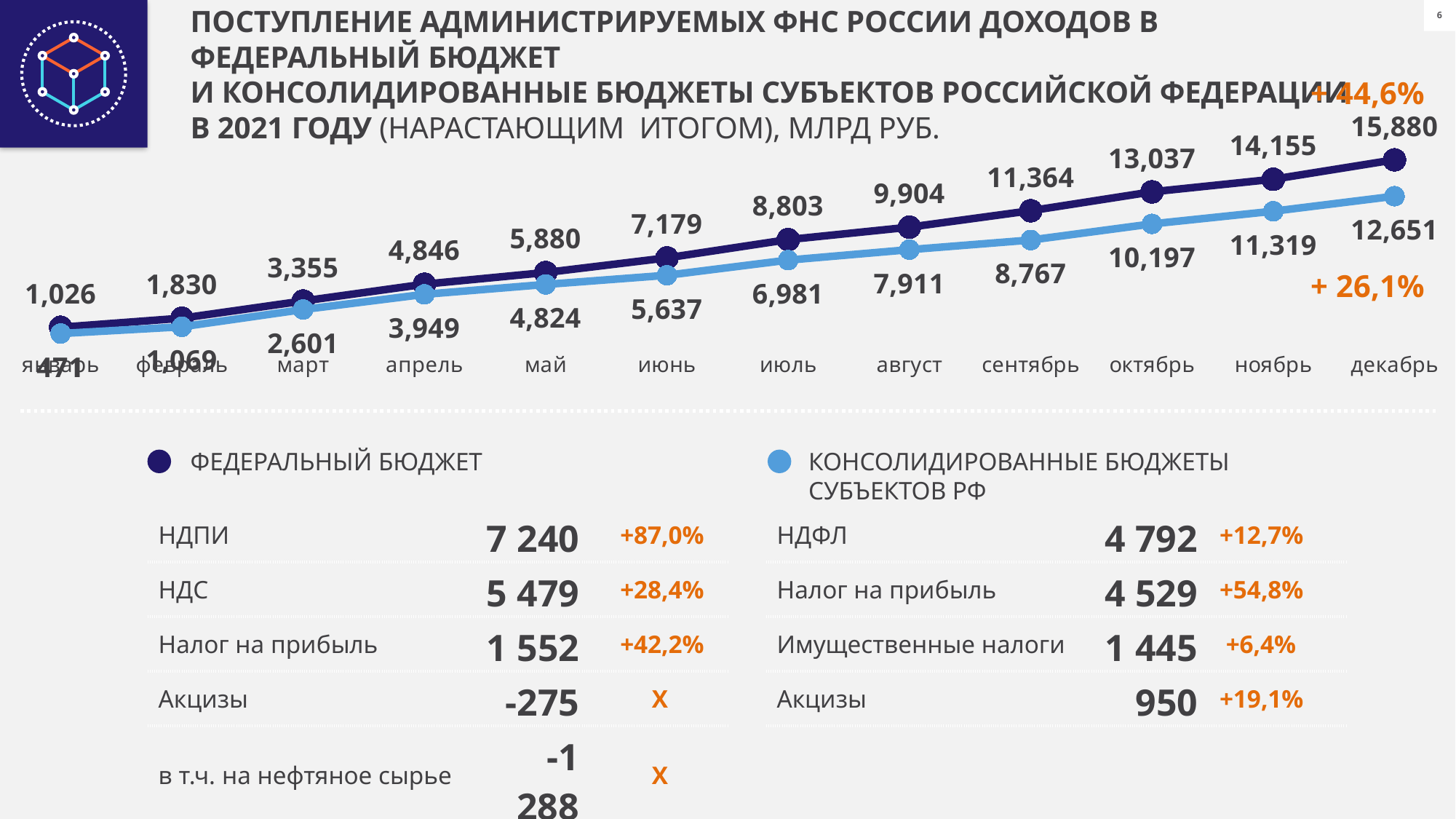
How many series does the chart's legend list? 2 What is the value for the federal budget in June (июнь)? 7,179 By how much did the federal budget value increase from November (ноябрь) to December (декабрь)? 1,725 What type of chart is shown on the slide? Line chart What is the value for the consolidated budgets of the subjects of the RF in September (сентябрь)? 8,767 In which month does the federal budget series have its lowest value? январь In which month does the federal budget series reach its highest value? декабрь Which series has the larger value in October (октябрь): the federal budget or the consolidated budgets of the subjects of the RF? Федеральный бюджет What is the value for the consolidated budgets of the subjects of the RF (Консолидированные бюджеты субъектов РФ) in December (декабрь)? 12,651 What is the value for the federal budget (Федеральный бюджет) in December (декабрь)? 15,880 What is the difference between the federal budget and the consolidated budgets of the subjects of the RF in December? 3,229 How many months are plotted on the x axis of the chart? 12